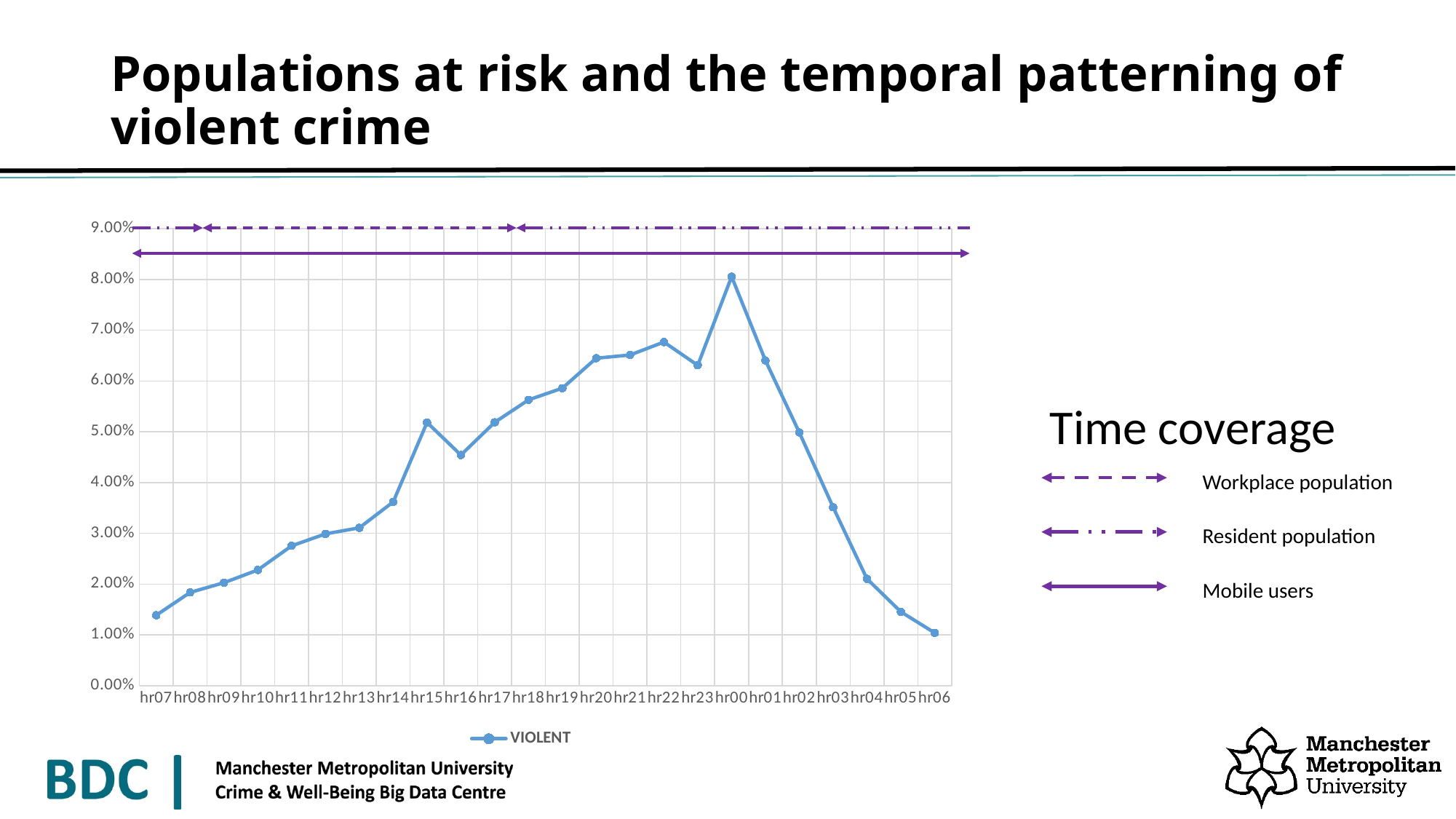
Which has the larger value, hr22 or hr23? hr22 Is the value for hr00 greater or less than 7.00%? greater Is the value for hr04 greater or less than 3.00%? less At which hour does the VIOLENT series reach its lowest value? hr06 Is the value for hr16 greater or less than 5.00%? less How many hourly categories are plotted along the x axis? 24 How many series does the chart legend list? 1 What kind of chart is shown on the slide? Line chart At which hour does the VIOLENT series reach its highest value? hr00 Does the VIOLENT series generally rise or fall from hr00 to hr06? fall What is the name of the series plotted in the chart? VIOLENT Which three populations are listed under the 'Time coverage' legend? Workplace population, Resident population, Mobile users